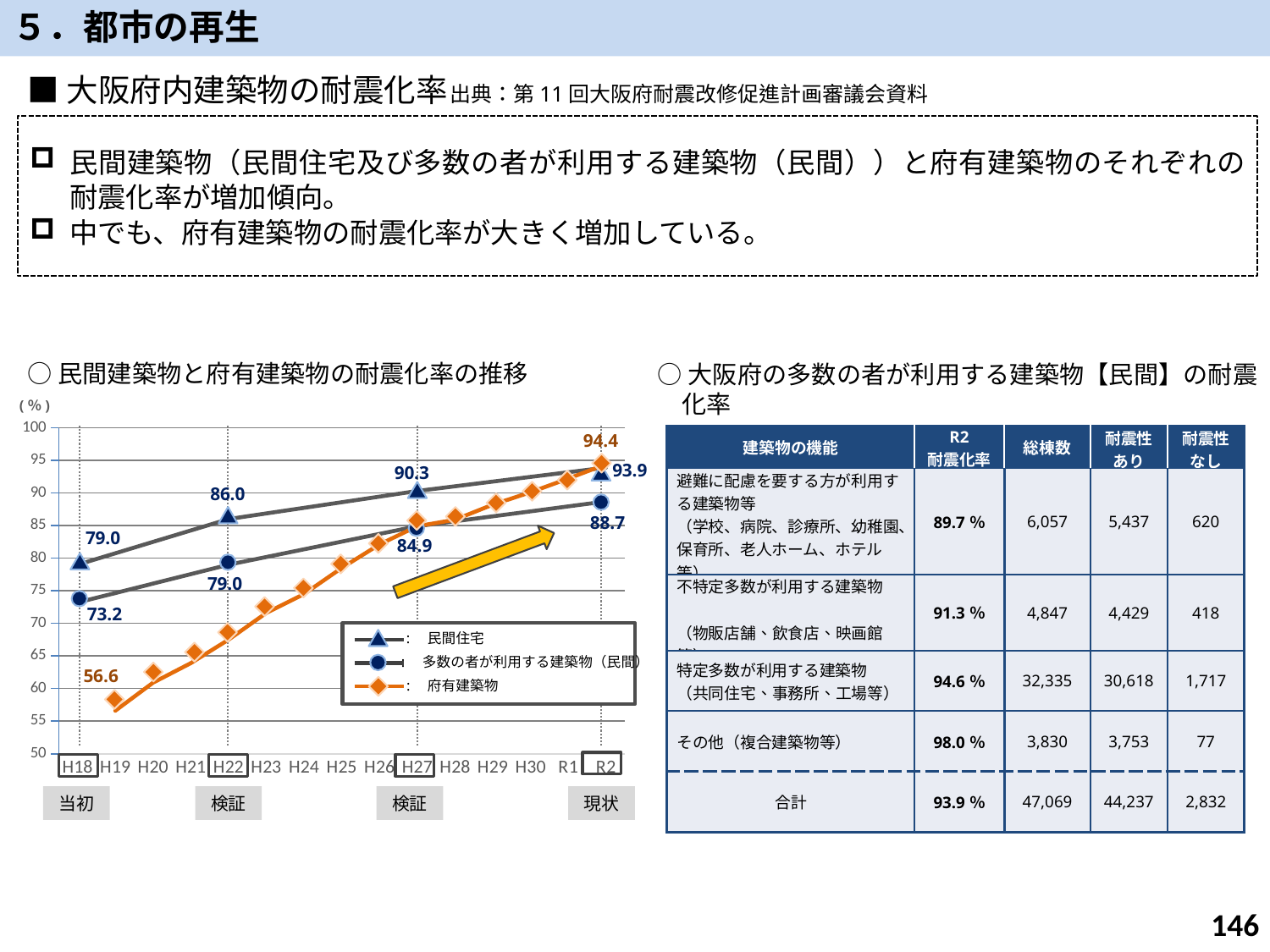
In the line chart, which series has the lowest value at H18? 多数の者が利用する建築物（民間） In the line chart, what is the value for 民間住宅 at H27? 90.3 In the line chart, is the value for 民間住宅 at H22 larger than the value for 多数の者が利用する建築物（民間） at H22? Yes In the line chart, what is the difference between the 民間住宅 value at R2 and at H18? 14.9 In the line chart, which series has the highest value at R2? 府有建築物 In the line chart, what is the value for 多数の者が利用する建築物（民間） at R2? 88.7 In the line chart, what is the value for 民間住宅 at H18? 79.0 In the line chart, do the values for 府有建築物 rise or fall from H18 to R2? rise How many series does the legend of the line chart list? 3 In the line chart, what is the value for 府有建築物 at R2? 94.4 What kind of chart is the chart titled 民間建築物と府有建築物の耐震化率の推移? line chart